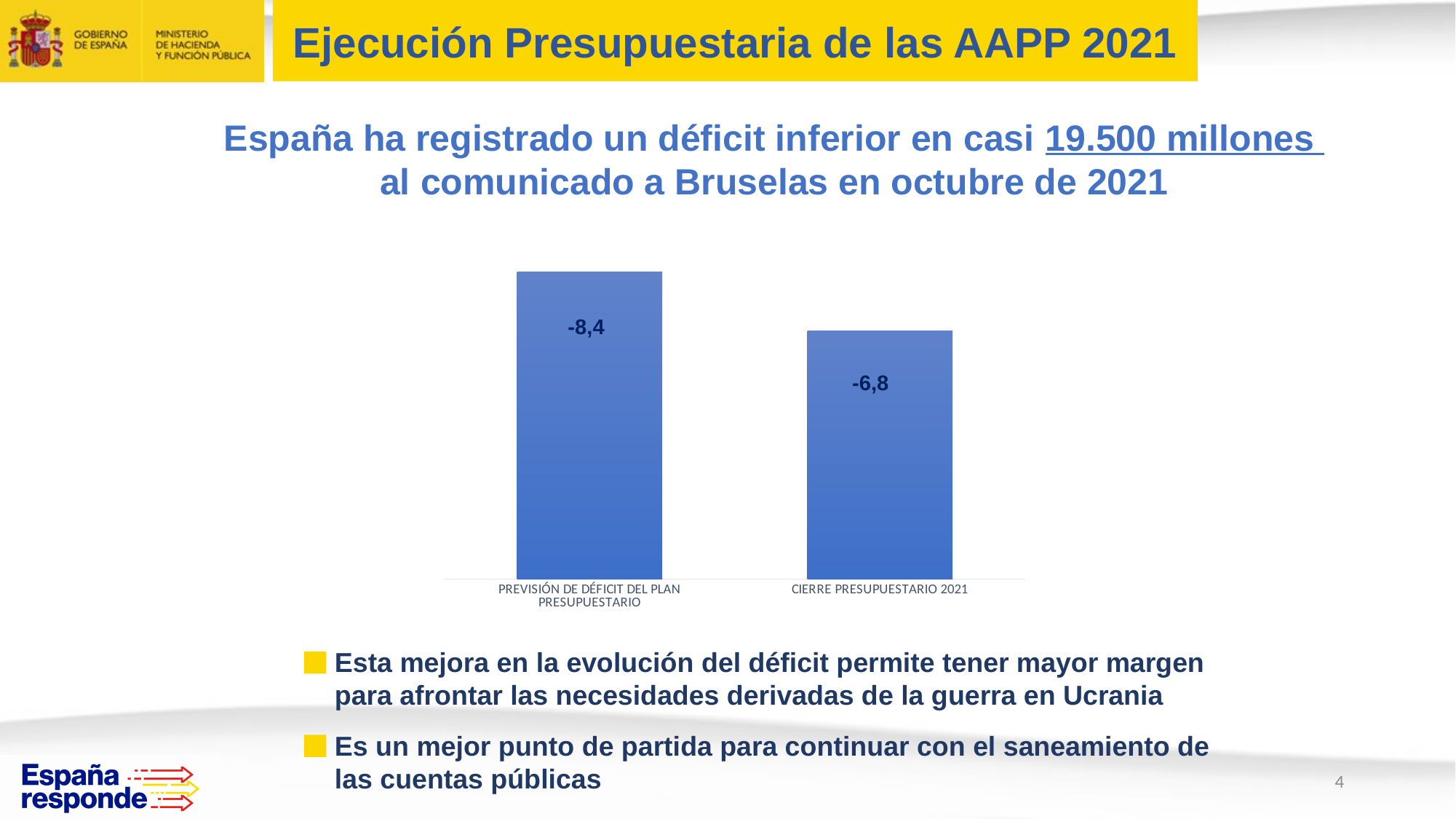
What kind of chart is shown on the slide? Bar chart How many categories are plotted in the chart? 2 Which category shows the larger deficit (the value furthest from zero)? PREVISIÓN DE DÉFICIT DEL PLAN PRESUPUESTARIO What colour are the bars in the chart? Blue What value is shown for PREVISIÓN DE DÉFICIT DEL PLAN PRESUPUESTARIO? -8,4 Do the bar values move closer to zero or further from zero from left to right? Closer to zero Which category shows the smaller deficit (the value closest to zero)? CIERRE PRESUPUESTARIO 2021 Which bar is taller, PREVISIÓN DE DÉFICIT DEL PLAN PRESUPUESTARIO or CIERRE PRESUPUESTARIO 2021? PREVISIÓN DE DÉFICIT DEL PLAN PRESUPUESTARIO What value is shown for CIERRE PRESUPUESTARIO 2021? -6,8 By how many points does the deficit for CIERRE PRESUPUESTARIO 2021 differ from the PREVISIÓN DE DÉFICIT DEL PLAN PRESUPUESTARIO? 1,6 What is the label of the right-hand bar in the chart? CIERRE PRESUPUESTARIO 2021